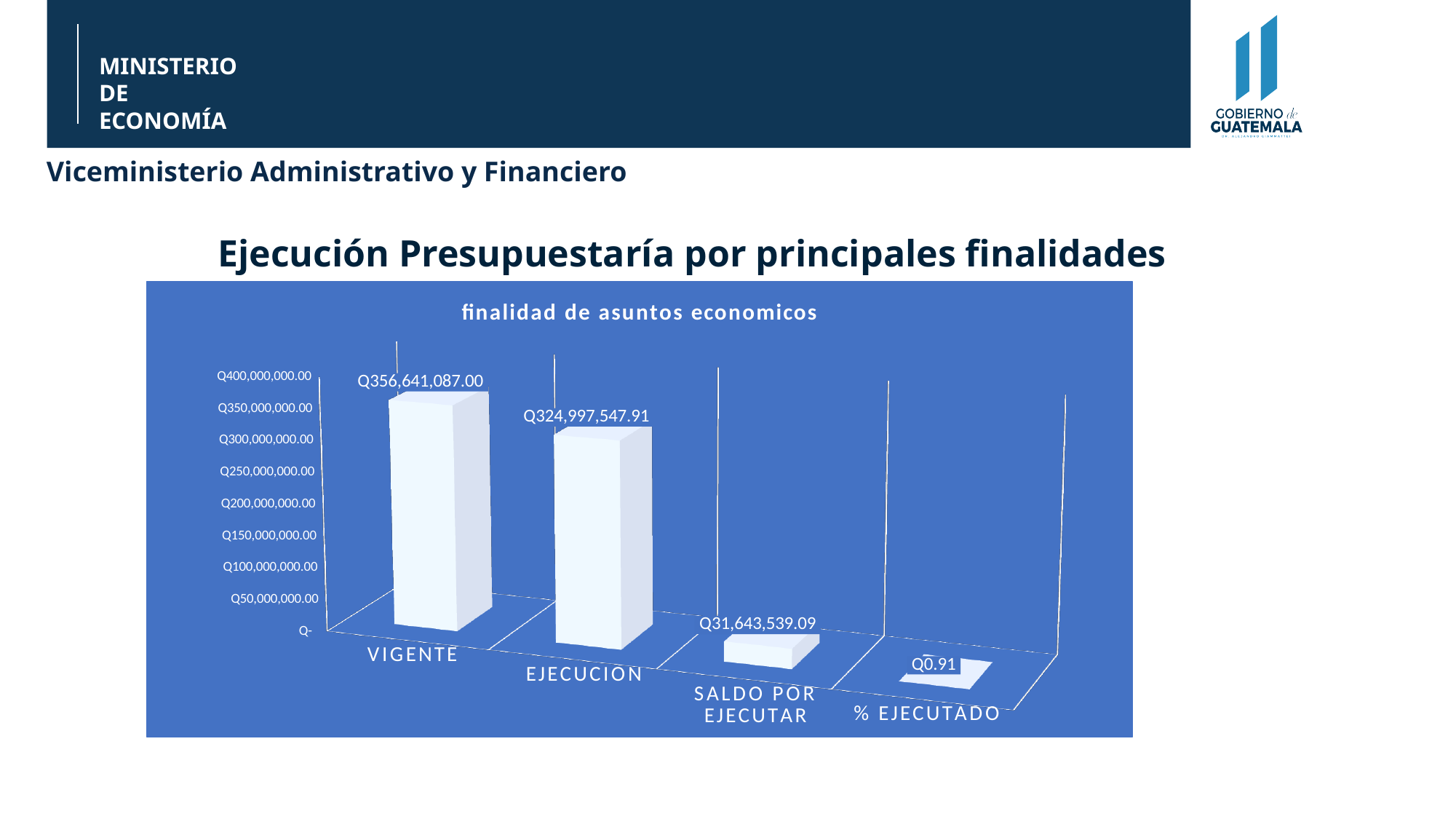
Which is larger, EJECUCION or SALDO POR EJECUTAR? EJECUCION What is the value for SALDO POR EJECUTAR? Q31,643,539.09 Which category has the lowest value? % EJECUTADO What is the value labelled for % EJECUTADO? Q0.91 How many categories are shown on the x axis? 4 Which category has the highest value? VIGENTE Is the value for EJECUCION greater or less than Q300,000,000.00? greater What is the difference between VIGENTE and EJECUCION? Q31,643,539.09 What is the value for VIGENTE? Q356,641,087.00 What is the value for EJECUCION? Q324,997,547.91 What is the title shown inside the chart area? finalidad de asuntos economicos What kind of chart is shown? bar chart